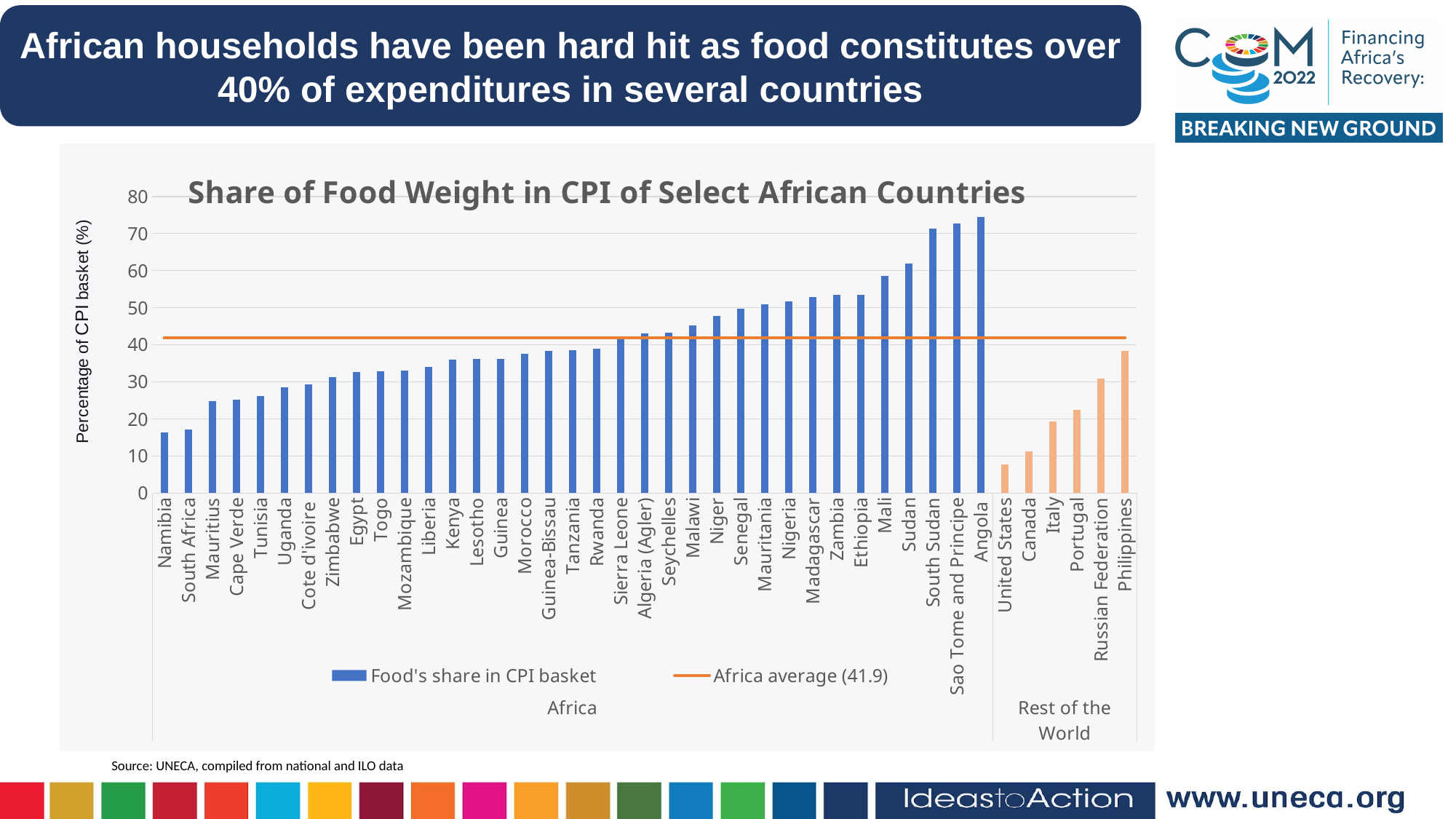
What type of chart is shown on the slide? Combination bar and line chart How many countries are shown in the 'Rest of the World' group? 6 Among the African countries, which has the lowest food share in the CPI basket? Namibia Which has a higher food share in the CPI basket, Philippines or Canada? Philippines Is the value for United States greater or less than 10? less Is the value for Namibia greater or less than 20? less How many series does the legend list? 2 What value does the legend give for the Africa average? 41.9 Is the value for Angola greater or less than 70? greater Which country has the lowest food share in the CPI basket on the chart? United States Which country has the highest food share in the CPI basket? Angola What is the title of the chart? Share of Food Weight in CPI of Select African Countries